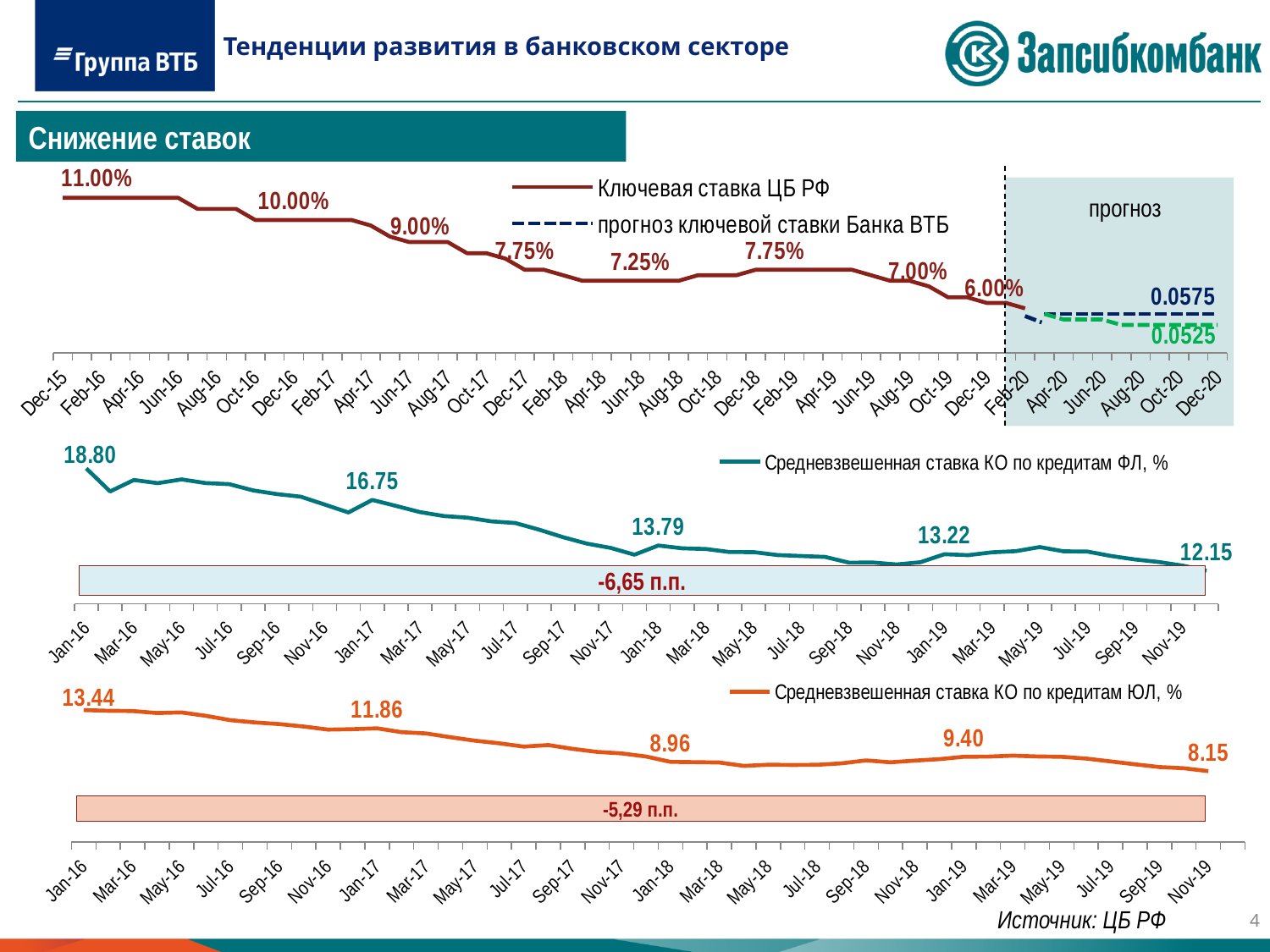
On the top chart, what is the last labelled actual value of the key rate before the forecast area? 6.00% What kind of chart is the top chart showing the key rate of the CB RF? line chart On the top chart, how many series does the legend list? 2 On the middle chart (weighted average rate on loans to individuals, ФЛ), what is the value labelled at Jan-16? 18.80 On the middle chart (ФЛ), what change in percentage points is shown in the band below the line? -6,65 п.п. On the top chart (key rate of the CB RF), what is the first labelled value at Dec-15? 11.00% On the middle chart (ФЛ), what is the value labelled at Nov-19? 12.15 On the top chart, does the key rate of the CB RF rise or fall from Dec-15 to Dec-19? fall On the middle chart (ФЛ), what is the difference between the labelled values 18.80 and 16.75? 2.05 On the bottom chart (ЮЛ), which labelled value is larger: 8.96 or 9.40? 9.40 On the bottom chart (ЮЛ), what is the value labelled at Nov-19? 8.15 On the bottom chart (weighted average rate on loans to legal entities, ЮЛ), what is the value labelled at Jan-16? 13.44